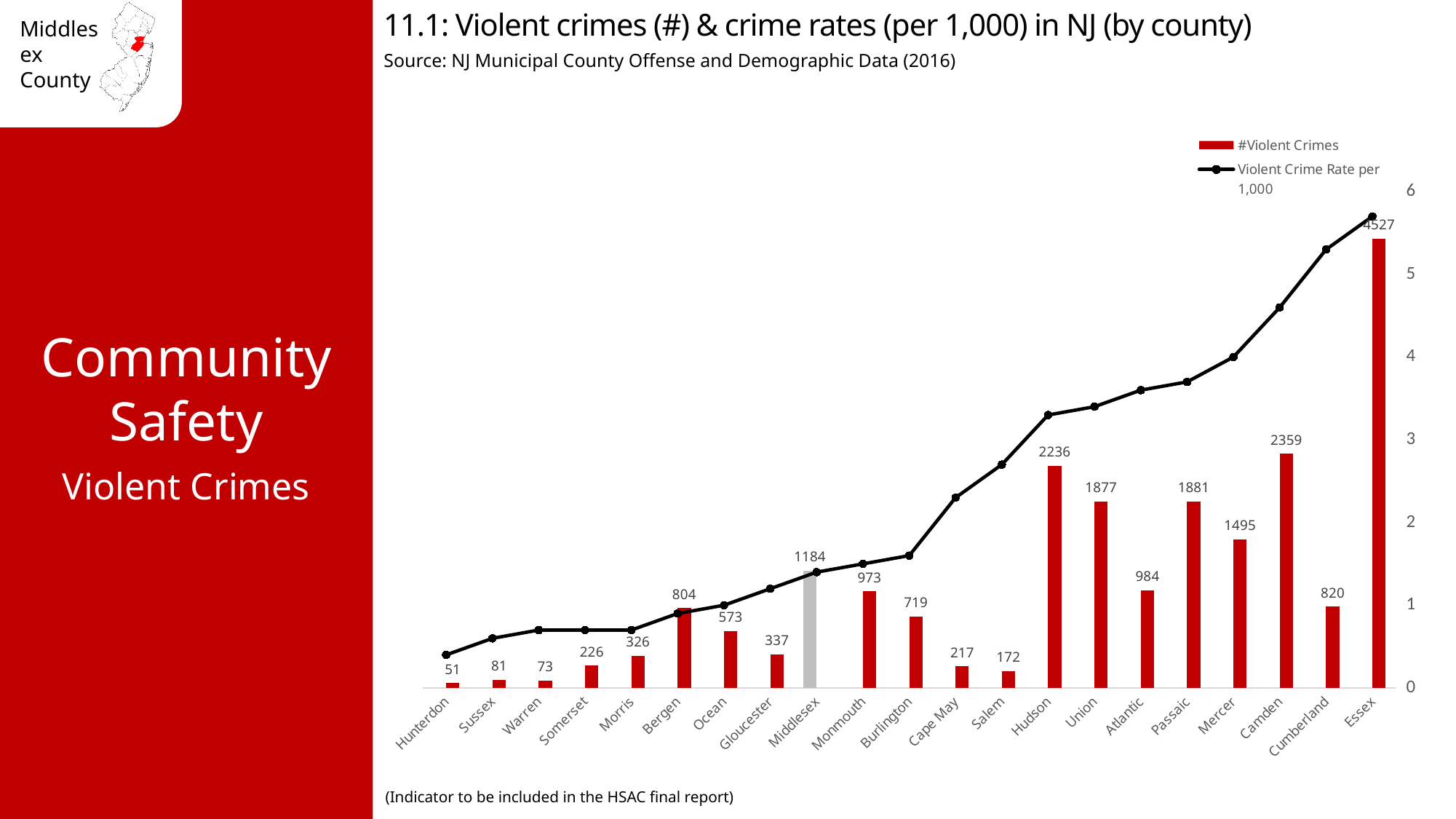
Which county has more violent crimes, Camden or Hudson? Camden What is the number of violent crimes for Hudson County? 2236 Does the violent crime rate per 1,000 line generally rise or fall from Hunterdon to Essex? Rise What is the difference in the number of violent crimes between Essex and Camden? 2168 What kind of chart is used to show the number of violent crimes by county? Bar chart How many counties are shown on the x axis of the chart? 21 How many series does the chart legend list? 2 Which county has the lowest number of violent crimes? Hunterdon Which county has the highest number of violent crimes? Essex Is the violent crime rate per 1,000 for Hunterdon greater or less than 1? less How many violent crimes are shown for Middlesex County? 1184 Is the violent crime rate per 1,000 for Essex greater or less than 5? greater